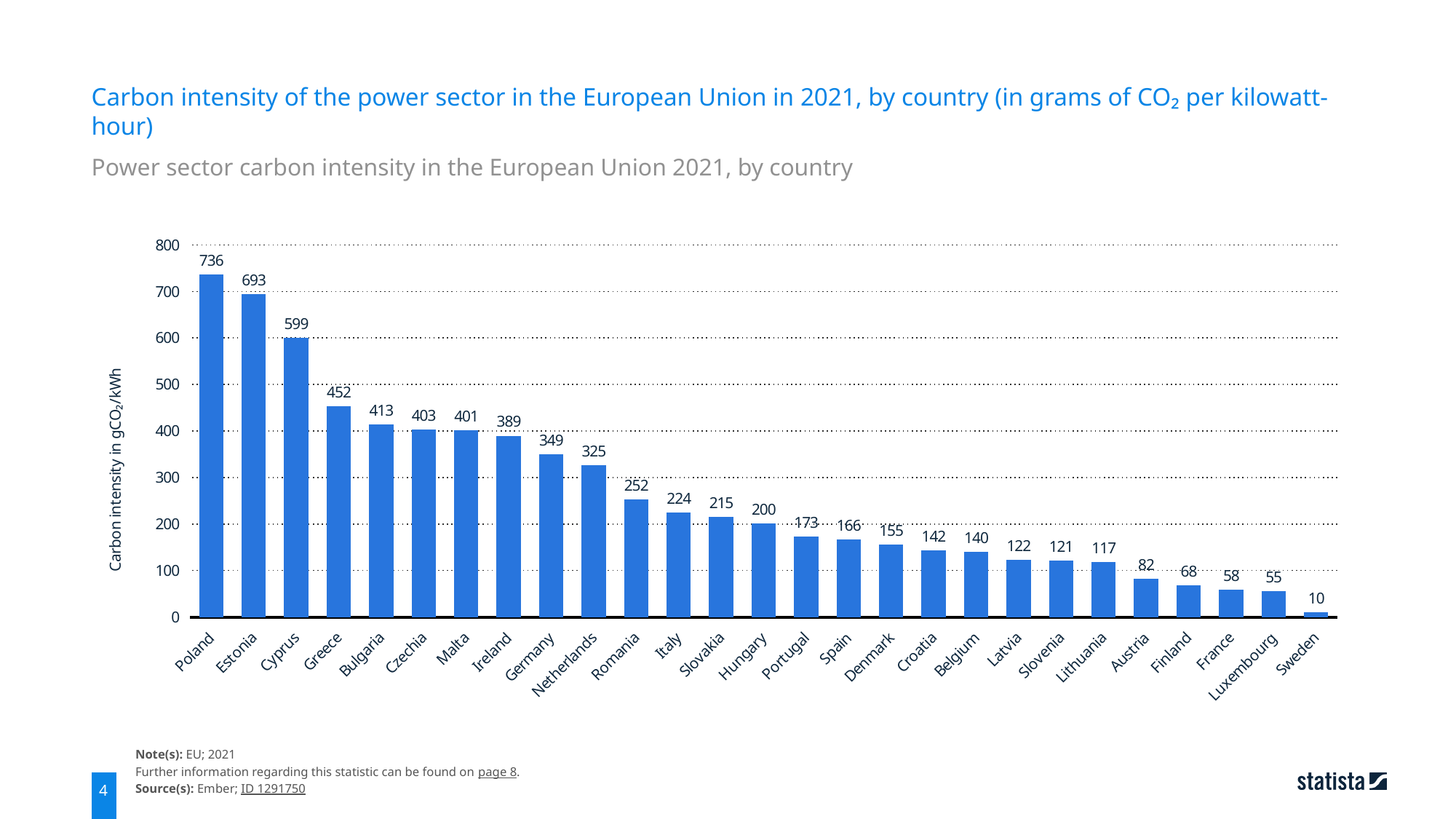
Which has a higher carbon intensity, Netherlands or Romania? Netherlands What is the carbon intensity value for France? 58 What is the difference between the values for Italy and Austria? 142 What is the label of the vertical axis? Carbon intensity in gCO₂/kWh What is the carbon intensity value for Germany? 349 Which has a lower carbon intensity, Finland or Luxembourg? Luxembourg Which country has the highest carbon intensity? Poland How many countries are shown in the chart? 27 What is the difference between the values for Poland and Estonia? 43 What kind of chart is shown on the slide? Bar chart What is the carbon intensity value for Spain? 166 Which country has the lowest carbon intensity? Sweden